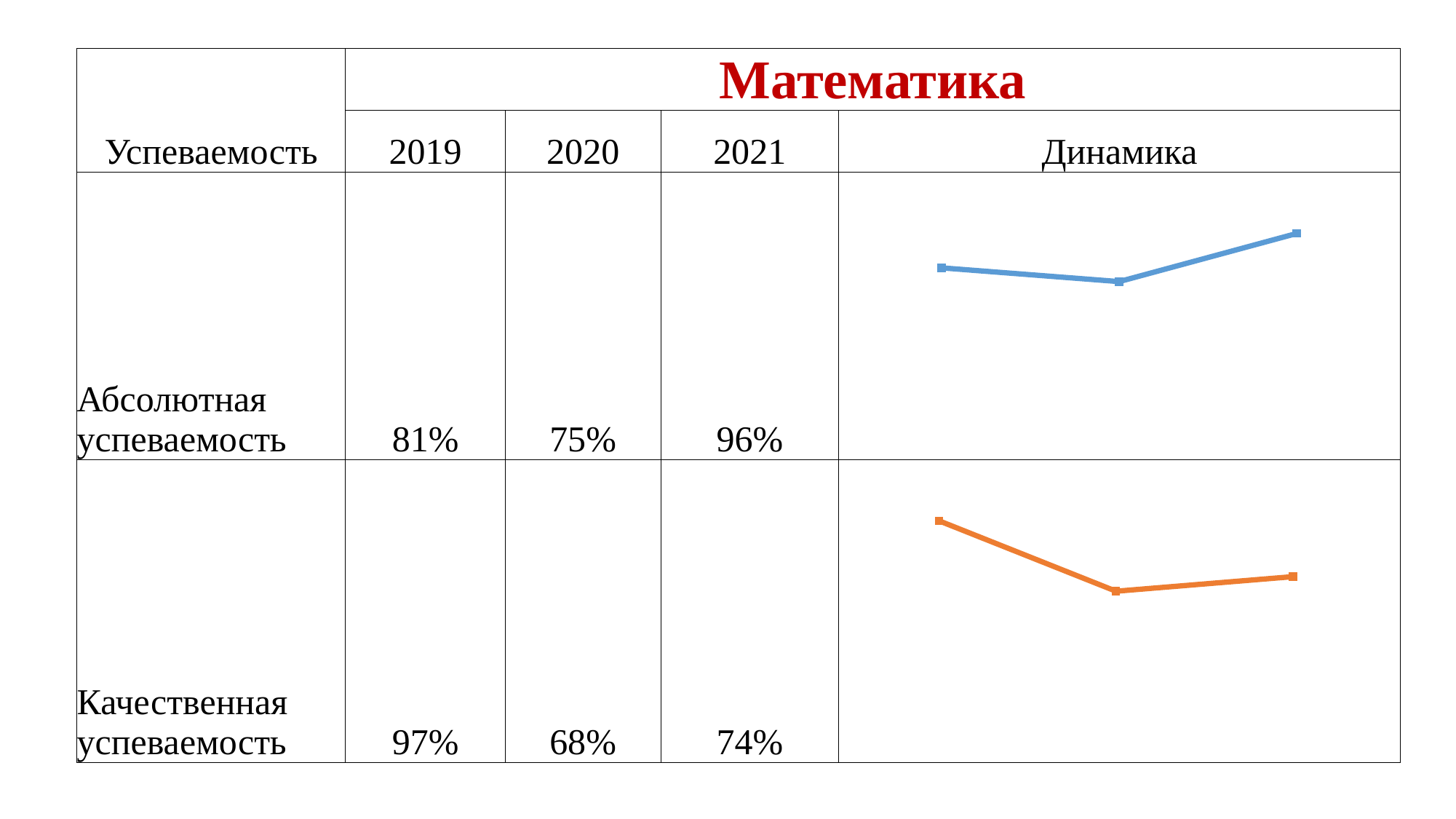
In the bottom chart (Качественная успеваемость), which year has the highest value? 2019 What type of chart is shown in the Динамика column for Абсолютная успеваемость? line chart In the top chart (Абсолютная успеваемость), what is the value for 2021? 96% In the bottom chart (Качественная успеваемость), what is the difference between the 2019 and 2020 values? 29% In the top chart (Абсолютная успеваемость), which year has the lowest value? 2020 In the top chart (Абсолютная успеваемость), does the line rise or fall from 2020 to 2021? rise How many data points does the top chart (Абсолютная успеваемость) plot? 3 What colour is the line in the bottom chart (Качественная успеваемость)? orange In the top chart (Абсолютная успеваемость), what is the difference between the 2021 and 2020 values? 21% In the bottom chart (Качественная успеваемость), which is larger: the value for 2020 or the value for 2021? 2021 In the bottom chart (Качественная успеваемость), does the line rise or fall from 2019 to 2020? fall In the bottom chart (Качественная успеваемость), what is the value for 2019? 97%